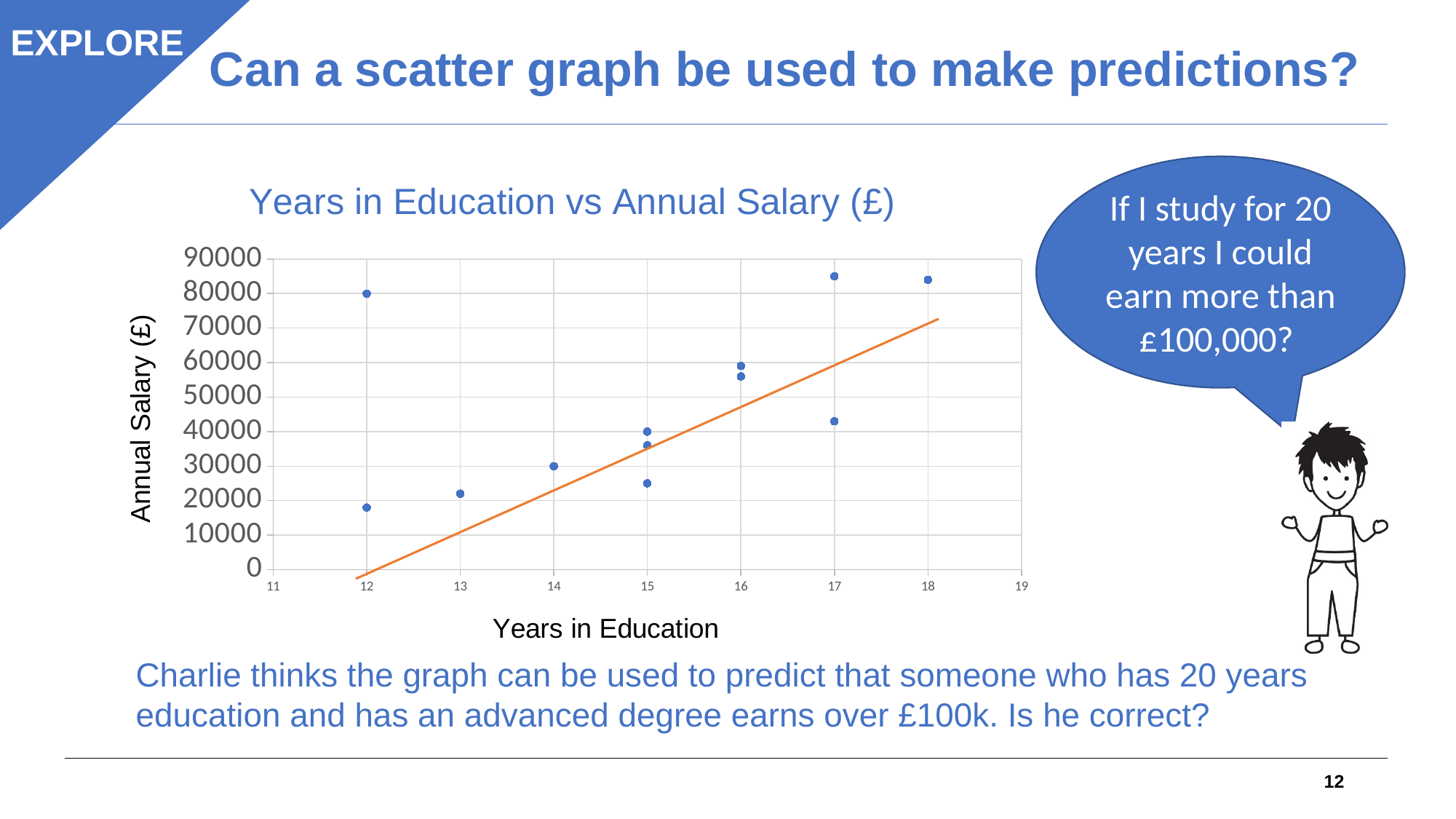
Is the annual salary for the highest point at 12 years in education greater or less than 70000? greater Is the annual salary for the point at 13 years in education greater or less than 30000? less Is the annual salary for the point at 14 years in education greater or less than 40000? less How many data points are plotted on the scatter chart? 12 What is the title of the chart? Years in Education vs Annual Salary (£) Does the trend line on the chart rise or fall as years in education increase? rise What kind of chart is shown on the slide? scatter chart What is the highest value shown on the vertical axis of the chart? 90000 What is the label of the vertical axis of the chart? Annual Salary (£)